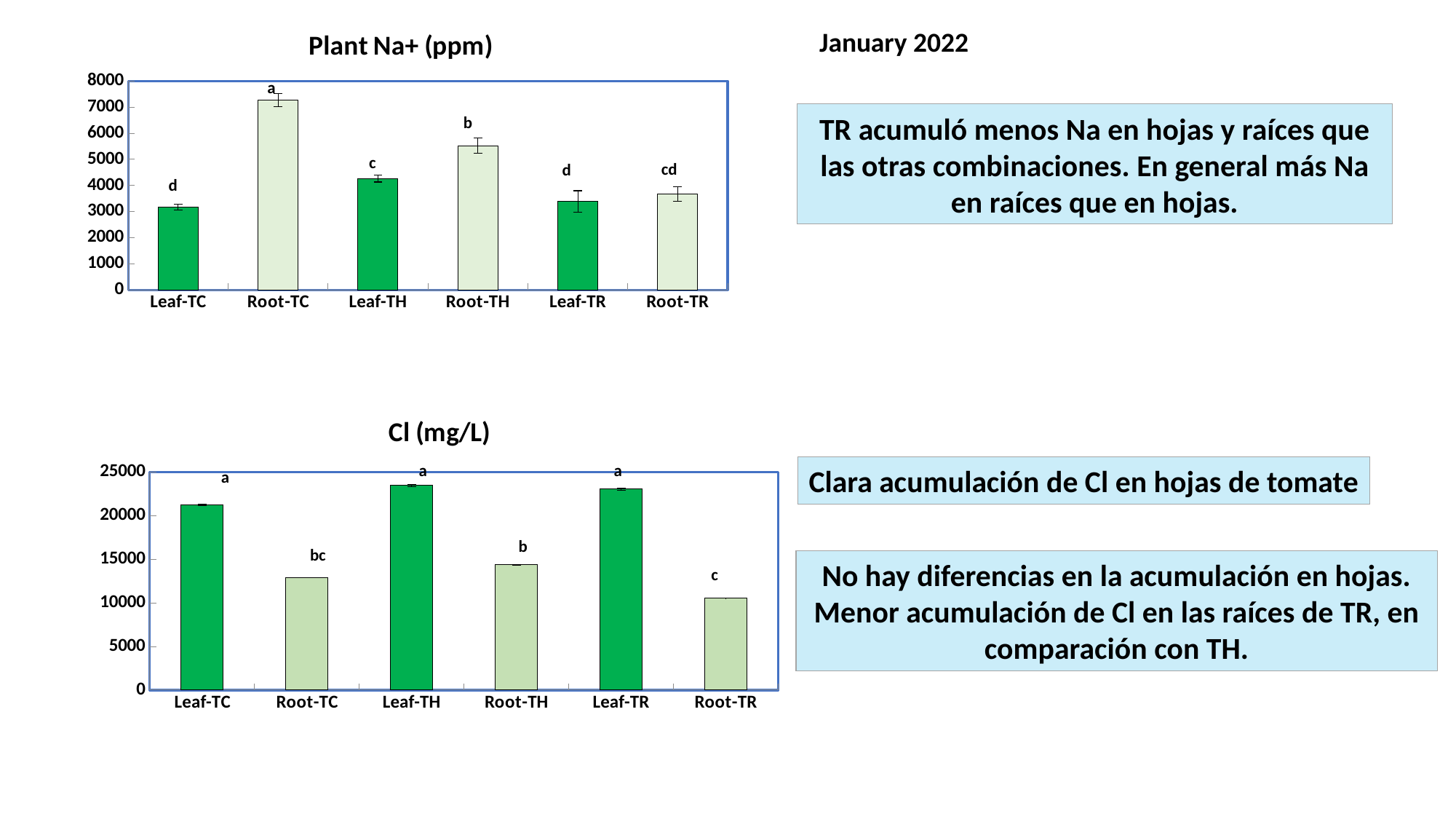
In the Cl (mg/L) chart, is the value for Leaf-TC greater or less than 20000? greater In the Plant Na+ (ppm) chart, is the value for Leaf-TR greater or less than 4000? less In the Plant Na+ (ppm) chart, what letter is printed above the Root-TC bar? a In the Cl (mg/L) chart, which is larger, Root-TH or Root-TR? Root-TH In the Plant Na+ (ppm) chart, is the value for Root-TH greater or less than 5000? greater How many categories are shown on the x axis of the Plant Na+ (ppm) chart? 6 In the Cl (mg/L) chart, which category has the lowest value? Root-TR In the Plant Na+ (ppm) chart, which is larger, Root-TH or Leaf-TH? Root-TH What kind of chart is the Cl (mg/L) chart? bar chart In the Plant Na+ (ppm) chart, which category has the highest value? Root-TC